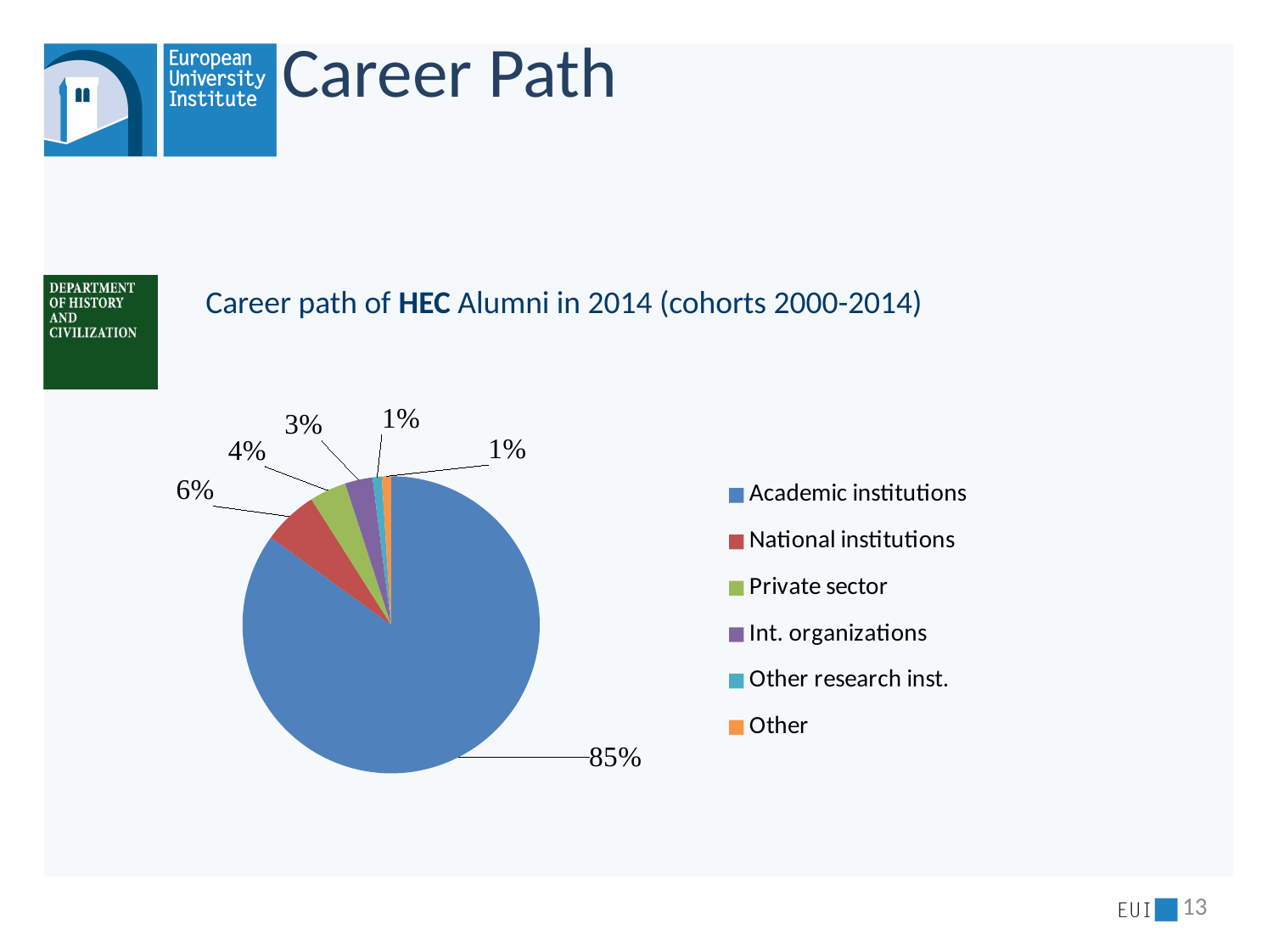
What is the value for National institutions? 6% What share of the pie does Academic institutions hold? 85% How many entries does the legend list? 6 What is the value for Private sector? 4% What is the value for Int. organizations? 3% Which category has the largest share of the pie? Academic institutions How many categories does the pie chart show? 6 What is the title of the chart? Career path of HEC Alumni in 2014 (cohorts 2000-2014) What is the difference between the shares of Academic institutions and National institutions? 79% What kind of chart is shown on the slide? Pie chart Which is larger, the share for Private sector or the share for Int. organizations? Private sector What is the value for Other research inst.? 1%